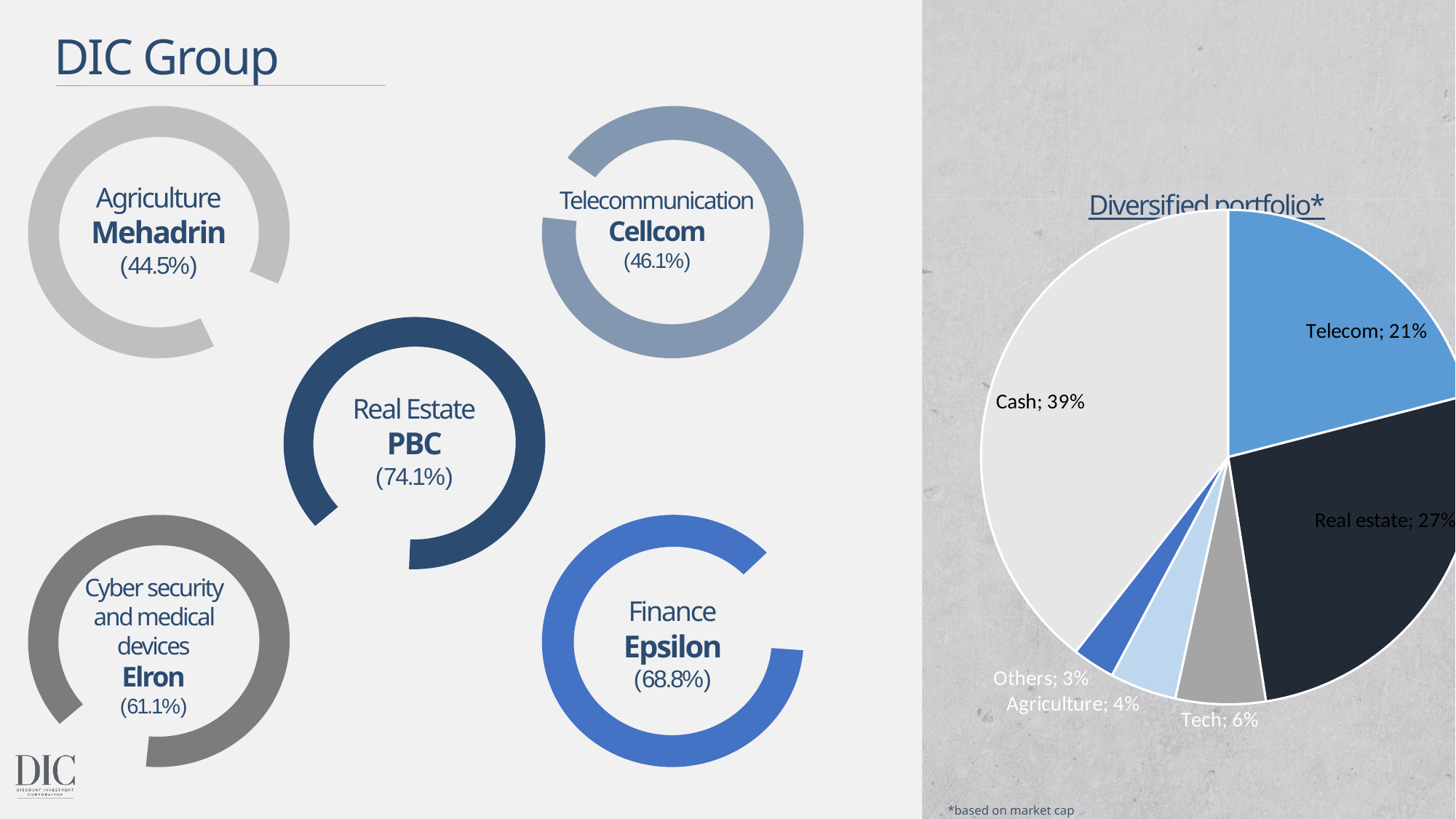
In the Diversified portfolio pie chart, what is the value for Telecom? 21% How many slices does the Diversified portfolio pie chart have? 6 What footnote explains the basis of the Diversified portfolio pie chart? *based on market cap Which slice is the largest in the Diversified portfolio pie chart? Cash In the Diversified portfolio pie chart, what is the value for Real estate? 27% In the Diversified portfolio pie chart, what is the difference between the Cash and Real estate shares? 12% What kind of chart is shown under the title "Diversified portfolio*"? pie chart In the Diversified portfolio pie chart, what is the value for Tech? 6% In the Diversified portfolio pie chart, which is larger: Telecom or Real estate? Real estate Which slice is the smallest in the Diversified portfolio pie chart? Others In the Diversified portfolio pie chart, what share does Cash hold? 39% In the Diversified portfolio pie chart, what is the value for Agriculture? 4%